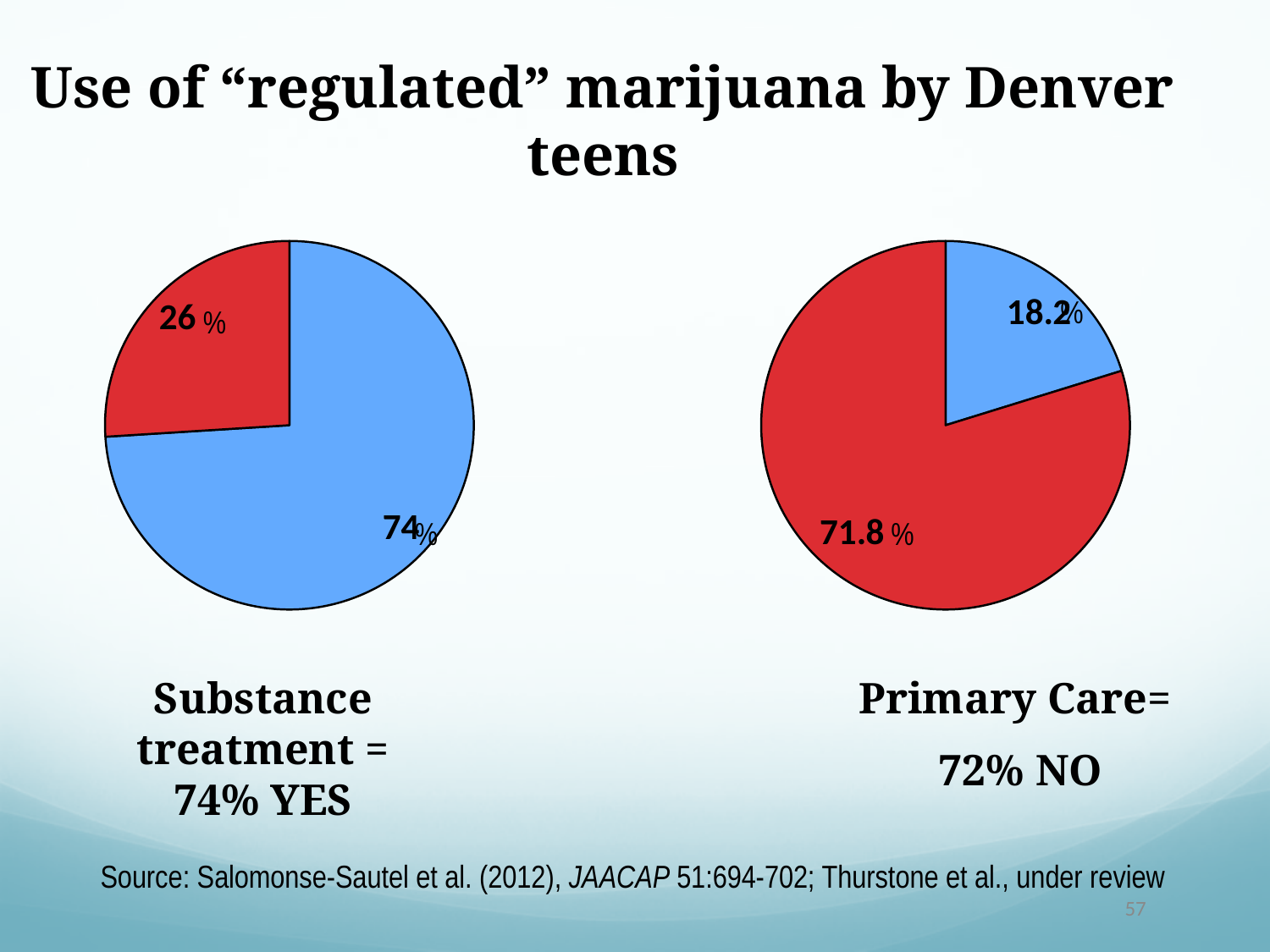
In the Primary Care pie chart, which slice is the largest? the red slice (71.8 %) What is the title of the slide containing the two pie charts? Use of "regulated" marijuana by Denver teens In the Primary Care pie chart, which slice is the smallest? the blue slice (18.2%) In the Substance treatment pie chart, what is the difference between the blue slice and the red slice? 48% In the Primary Care pie chart, what percentage is shown for the red slice? 71.8 % How many slices does the Substance treatment pie chart have? 2 In the Primary Care pie chart, what is the difference between the red slice and the blue slice? 53.6% In the Substance treatment pie chart, what percentage is shown for the red slice? 26 % In the Substance treatment pie chart, what percentage is shown for the blue slice? 74% In the Primary Care pie chart, what percentage is shown for the blue slice? 18.2% What kind of chart is used on the left side of the slide? pie chart In the Substance treatment pie chart, which slice is larger, the blue one or the red one? blue